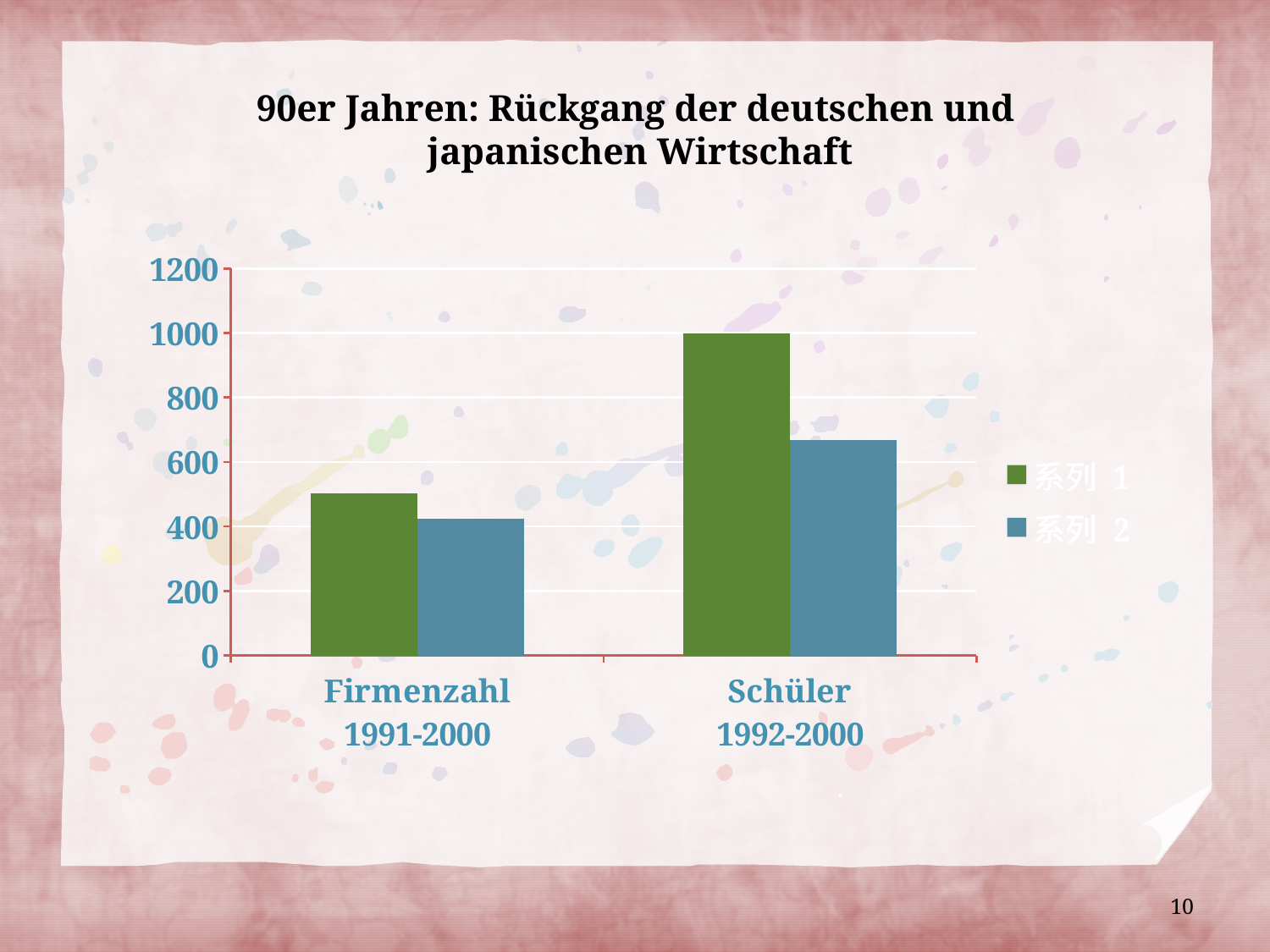
How many series does the chart's legend list? 2 How many categories are shown on the x axis of the chart? 2 Which category has the highest value for 系列 1? Schüler 1992-2000 What kind of chart is shown on the slide? bar chart Is the value of 系列 1 for Firmenzahl 1991-2000 greater or less than 400? greater For Schüler 1992-2000, which series has the larger value, 系列 1 or 系列 2? 系列 1 Is the value of 系列 2 for Schüler 1992-2000 greater or less than 800? less Is the value of 系列 2 for Firmenzahl 1991-2000 greater or less than 600? less Which legend entry is shown in green? 系列 1 Which category has the lowest value for 系列 2? Firmenzahl 1991-2000